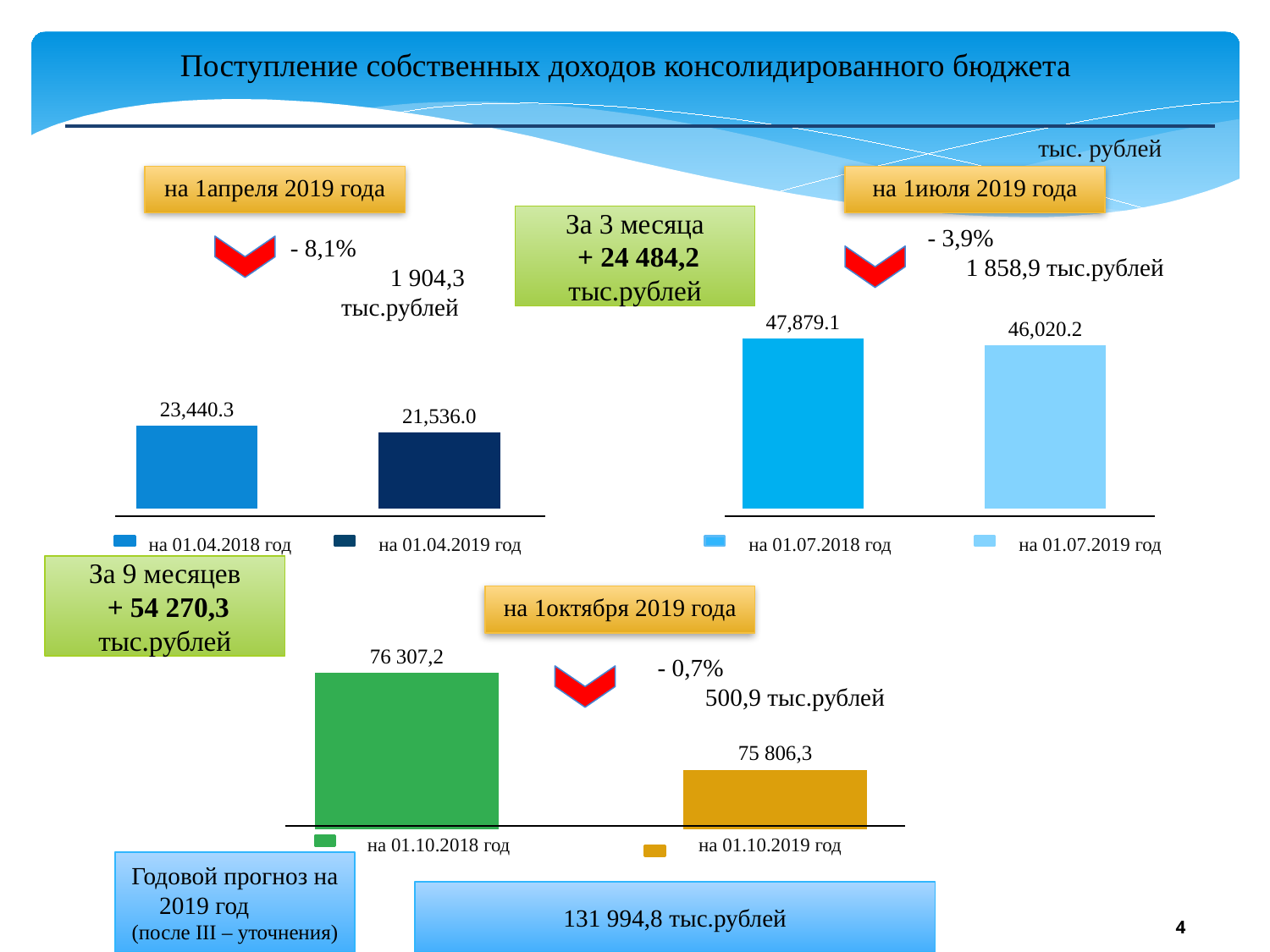
In the chart labelled 'на 1октября 2019 года', what is the value for 'на 01.10.2018 год'? 76 307,2 In the chart labelled 'на 1июля 2019 года', what is the value for 'на 01.07.2019 год'? 46,020.2 How many series does the legend of the chart labelled 'на 1октября 2019 года' list? 2 In the chart labelled 'на 1июля 2019 года', what is the value for 'на 01.07.2018 год'? 47,879.1 What type of chart is the chart labelled 'на 1октября 2019 года'? bar chart In the chart labelled 'на 1октября 2019 года', what is the value for 'на 01.10.2019 год'? 75 806,3 In the chart labelled 'на 1апреля 2019 года', what is the value for 'на 01.04.2019 год'? 21,536.0 In the chart labelled 'на 1июля 2019 года', which series has the lower value? на 01.07.2019 год In the chart labelled 'на 1апреля 2019 года', what is the difference between the values for 'на 01.04.2018 год' and 'на 01.04.2019 год'? 1,904.3 In the chart labelled 'на 1июля 2019 года', what is the difference between the values for 'на 01.07.2018 год' and 'на 01.07.2019 год'? 1,858.9 In the chart labelled 'на 1апреля 2019 года', which series has the higher value? на 01.04.2018 год In the chart labelled 'на 1апреля 2019 года', what is the value for 'на 01.04.2018 год'? 23,440.3